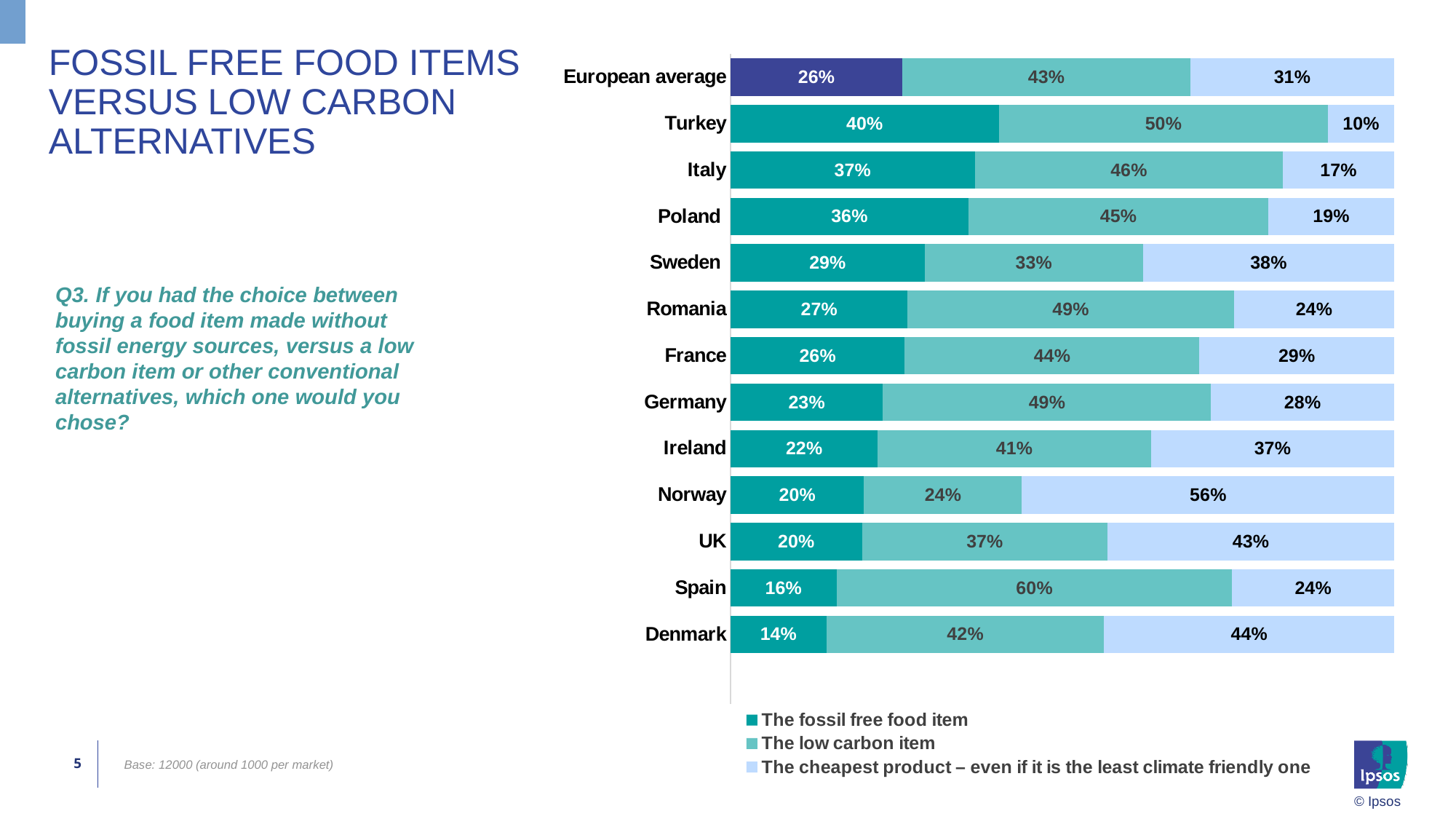
What percentage of respondents in Norway would choose the cheapest product? 56% How many series does the legend list? 3 What percentage of respondents in Turkey would choose the fossil free food item? 40% Which country has the lowest share choosing the cheapest product? Turkey What is the total of the three segments for the European average bar? 100% How many categories (rows) are shown on the chart? 13 Which country has the highest share choosing the fossil free food item? Turkey What is the difference between the cheapest product share in Norway and in Turkey? 46 percentage points Which country has the lowest share choosing the fossil free food item? Denmark What kind of chart is shown on the slide? Stacked horizontal bar chart What is the value for the low carbon item in Spain? 60% Which is larger: the low carbon item share in Sweden or in Romania? Romania